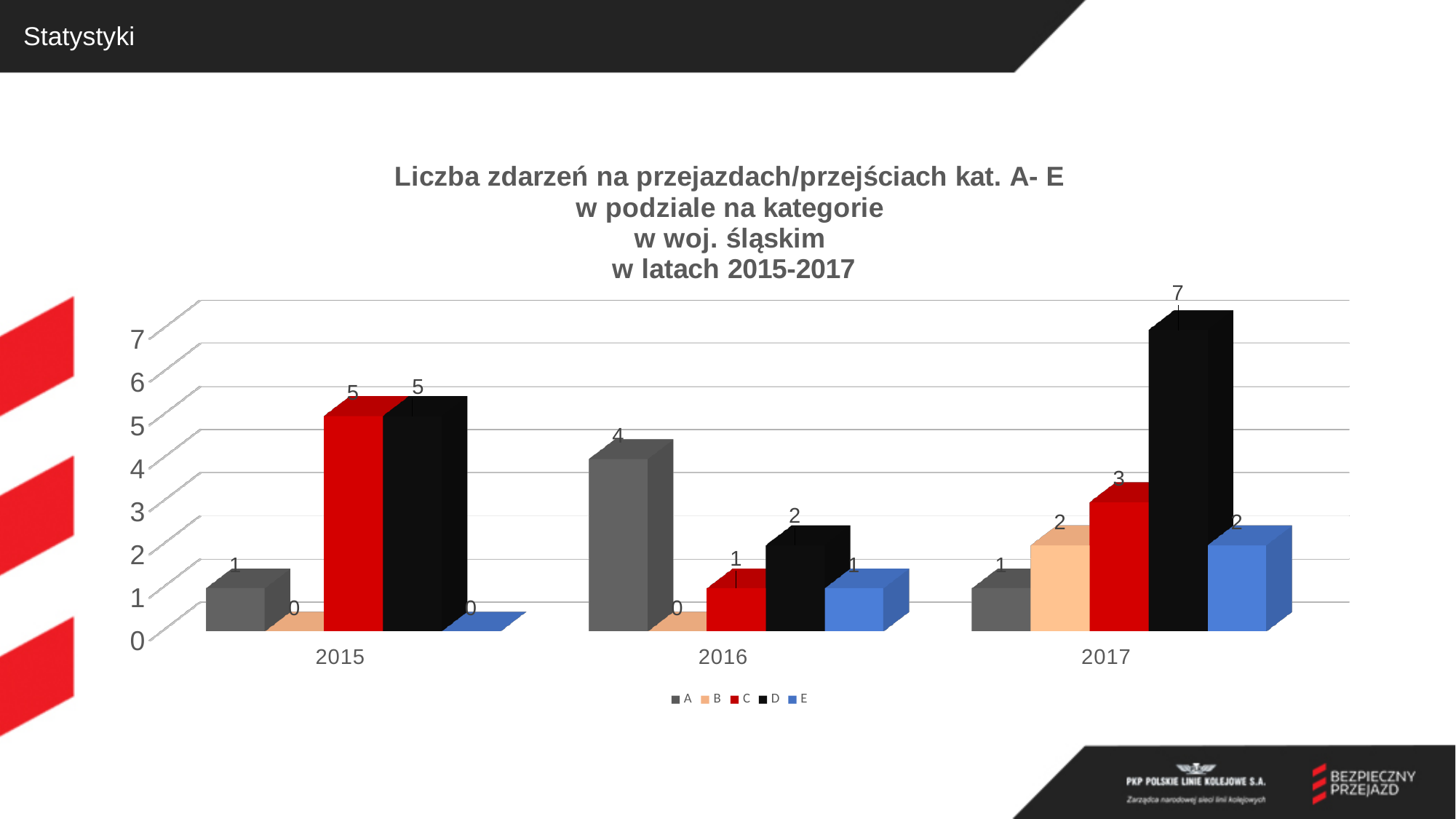
Which series has the highest value in 2016? A What kind of chart is shown on the slide? Bar chart What is the value for series B in 2017? 2 What is the value for series D in 2017? 7 How many year categories are shown on the x axis? 3 What is the total of the values for all five series in 2017? 15 What is the difference between the values for series D in 2017 and series D in 2016? 5 What is the value for series C in 2015? 5 How many series does the legend list? 5 Which is larger: the value for series C in 2017 or the value for series E in 2017? C in 2017 What is the value for series A in 2016? 4 Which series has the highest value in 2017? D